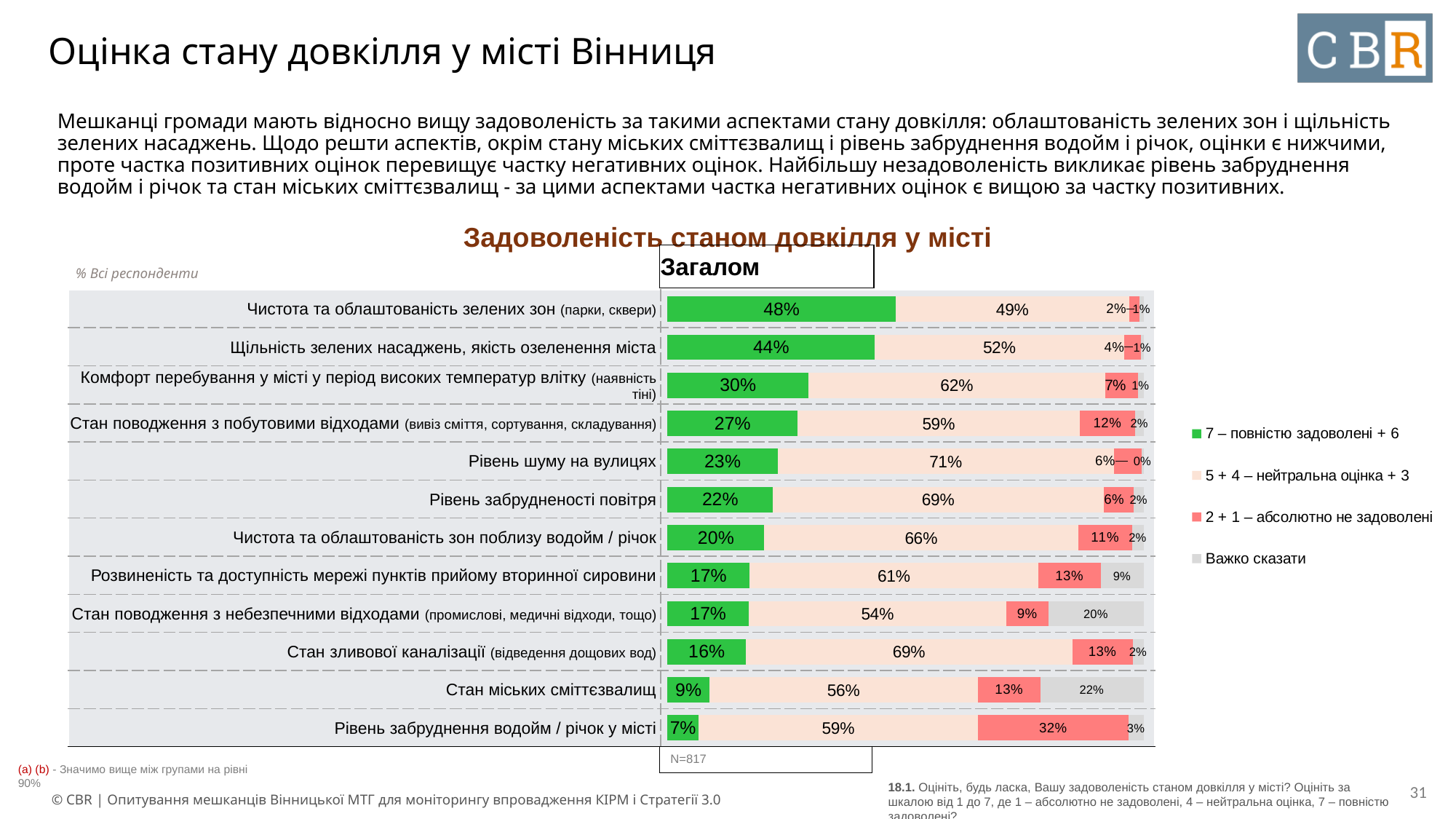
What is the share of 'Важко сказати' for 'Стан міських сміттєзвалищ'? 22% Which category has the lowest share of '7 – повністю задоволені + 6'? Рівень забруднення водойм / річок у місті What is the total of the four segments for 'Стан зливової каналізації'? 100% What is the difference between the '5 + 4 – нейтральна оцінка + 3' share for 'Рівень шуму на вулицях' and for 'Стан поводження з небезпечними відходами'? 17% Which category has the highest share of '7 – повністю задоволені + 6'? Чистота та облаштованість зелених зон How many categories (aspects) are plotted in the chart? 12 What type of chart is shown on the slide? Stacked bar chart What is the share of '7 – повністю задоволені + 6' for 'Чистота та облаштованість зелених зон'? 48% How many series does the legend list? 4 Which has a larger share of '2 + 1 – абсолютно не задоволені': 'Стан поводження з побутовими відходами' or 'Рівень забрудненості повітря'? Стан поводження з побутовими відходами What is the share of '2 + 1 – абсолютно не задоволені' for 'Рівень забруднення водойм / річок у місті'? 32% What is the sample size (N) shown below the chart? N=817